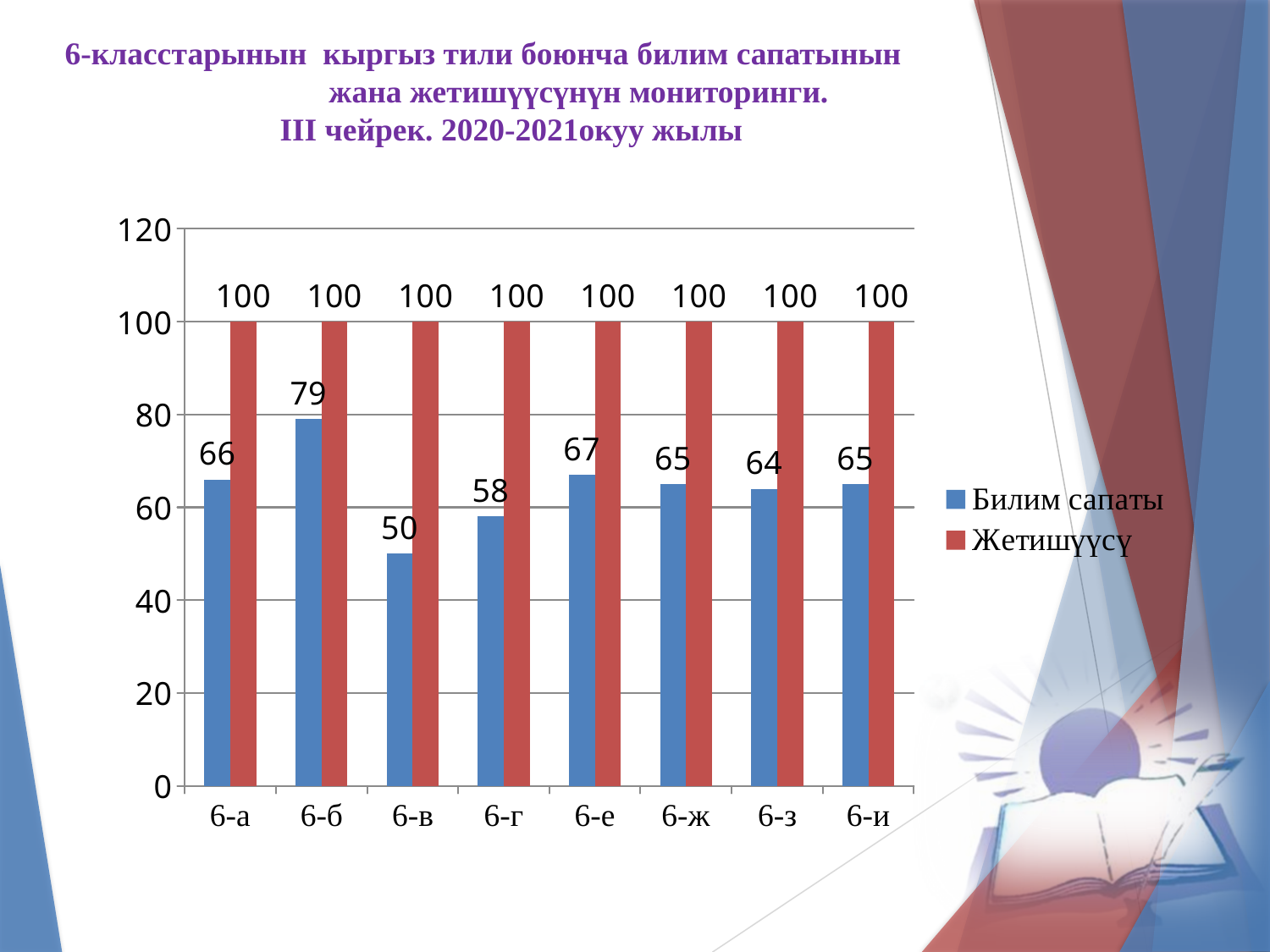
What colour are the Жетишүүсү bars? red What is the difference between the Билим сапаты values for 6-б and 6-в? 29 Which class has the highest Билим сапаты value? 6-б What kind of chart is shown on the slide? bar chart Which class has the lowest Билим сапаты value? 6-в What is the Билим сапаты value for class 6-б? 79 Which is larger, the Билим сапаты value for 6-а or for 6-е? 6-е What is the Жетишүүсү value for class 6-г? 100 What is the Билим сапаты value for class 6-в? 50 Is the Билим сапаты value for 6-г greater or less than 60? less How many series does the legend list? 2 How many classes are shown on the x axis? 8